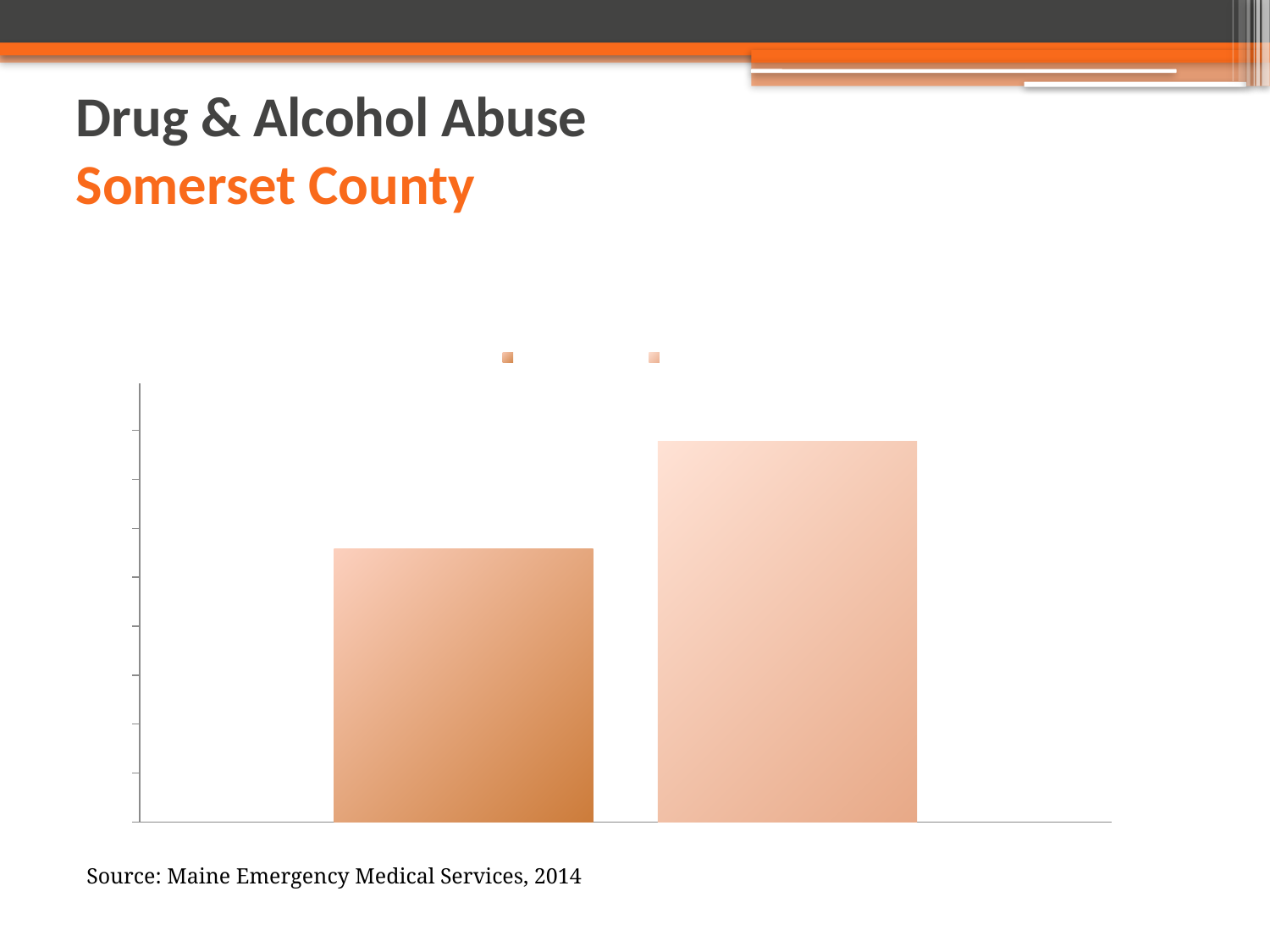
Which county does the slide title say the chart is about? Somerset County Which bar is taller, the left bar or the right bar? the right bar What kind of chart is shown on the slide? bar chart What source is cited below the chart? Maine Emergency Medical Services, 2014 How many entries does the chart's legend show? 2 How many bars are plotted in the chart? 2 Do the bar heights rise or fall from left to right? rise Which bar is the shortest in the chart? the left bar